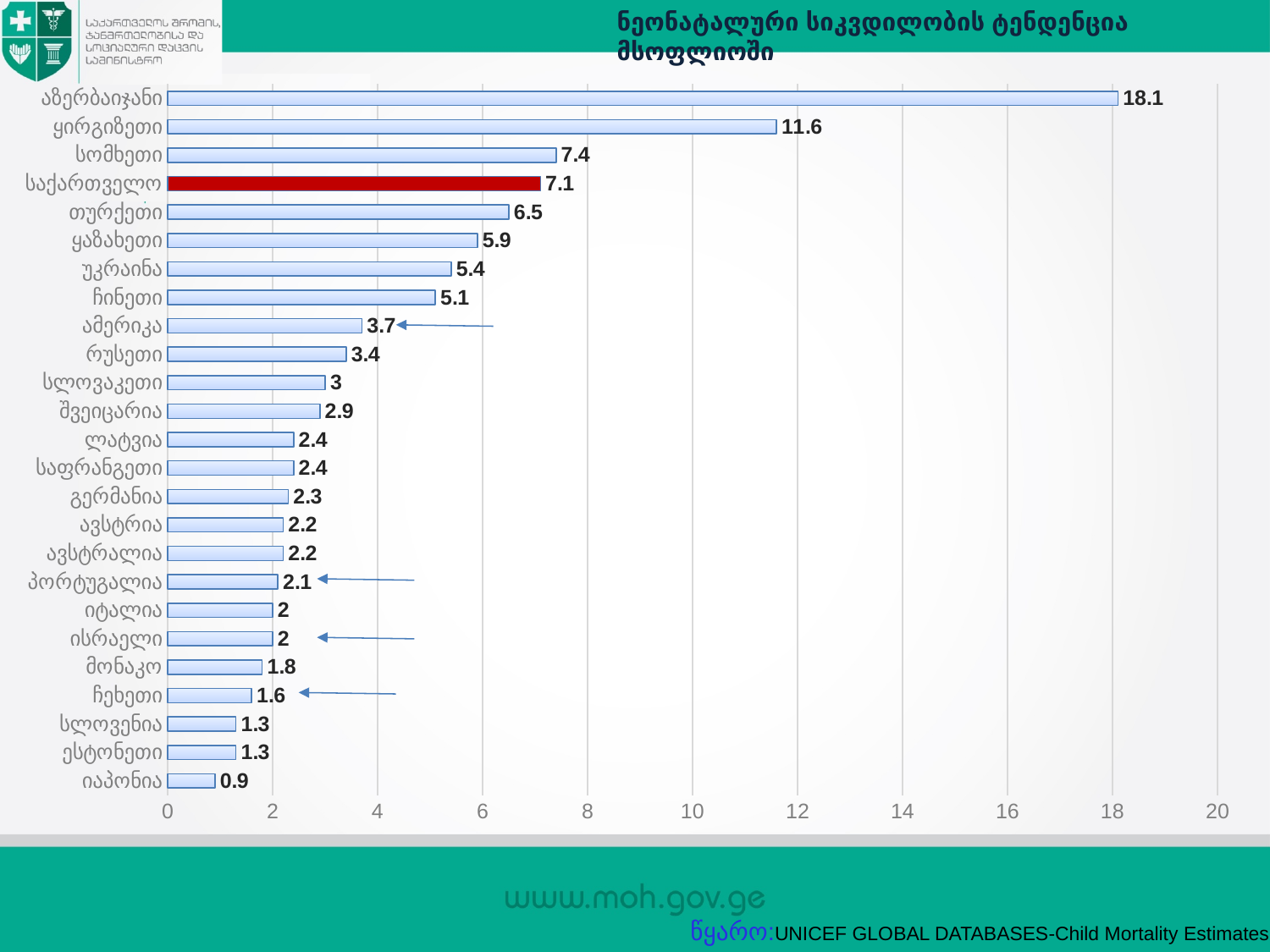
Which category has the highest value? აზერბაიჯანი Is the value for ყირგიზეთი greater or less than 10? greater Which bar is highlighted in a different colour (red) from the others? საქართველო What is the difference between the values for აზერბაიჯანი and ყირგიზეთი? 6.5 How many categories are shown in the chart? 25 Which category has the lowest value? იაპონია Which is larger, the value for თურქეთი or the value for უკრაინა? თურქეთი What is the value for იაპონია? 0.9 What is the value for საქართველო? 7.1 What kind of chart is shown on the slide? bar chart What is the value for ჩინეთი? 5.1 What is the value for აზერბაიჯანი? 18.1